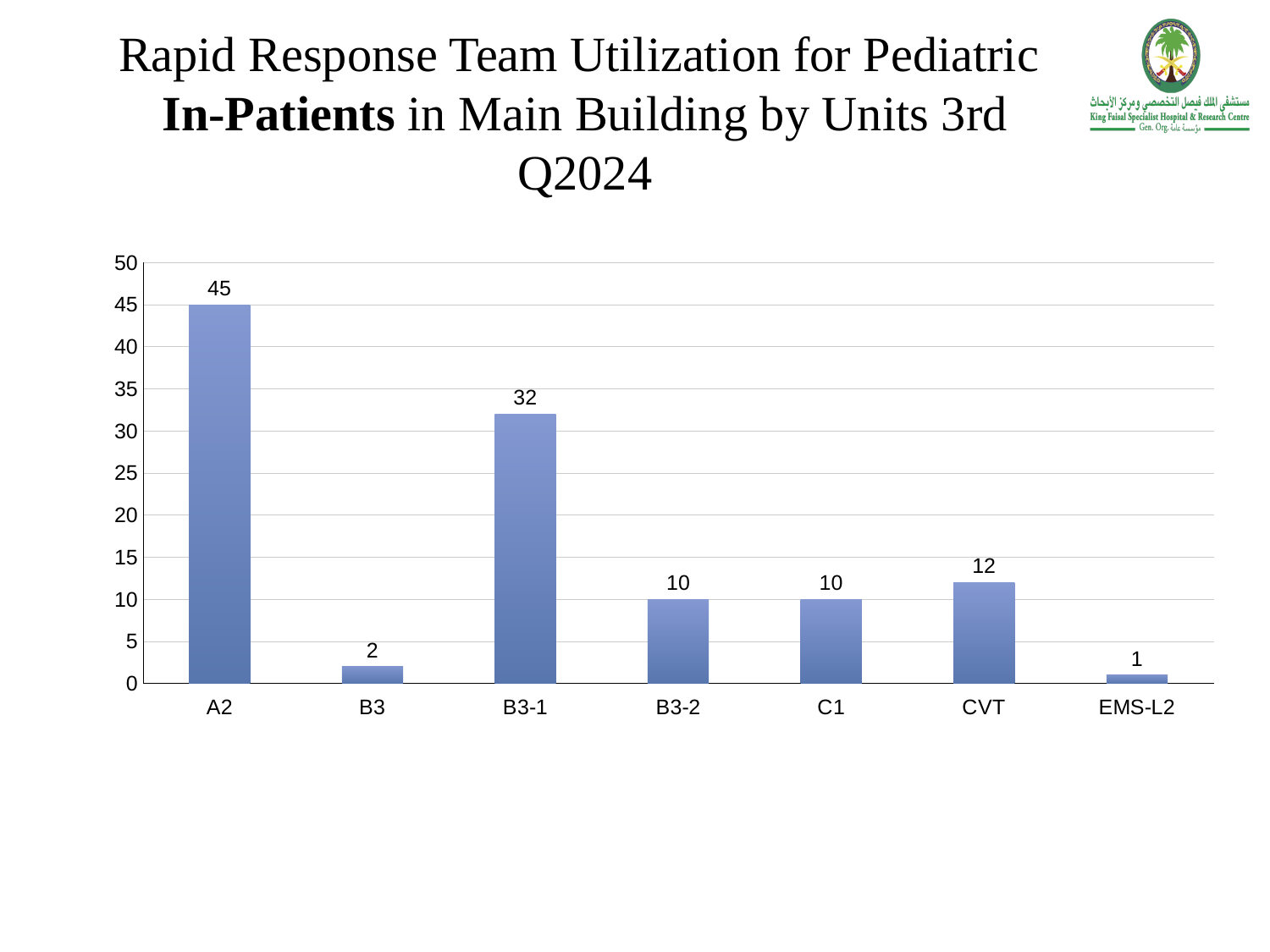
What is the value for A2? 45 What is the value for B3-1? 32 Which unit has the highest value? A2 What is the difference between the values for A2 and B3-1? 13 How many units are shown on the x axis? 7 What kind of chart is shown on the slide? bar chart What is the value for EMS-L2? 1 Which unit has the lowest value? EMS-L2 What is the value for CVT? 12 Which is larger, the value for B3-1 or the value for CVT? B3-1 Is the value for A2 greater or less than 40? greater What is the difference between the values for CVT and B3? 10